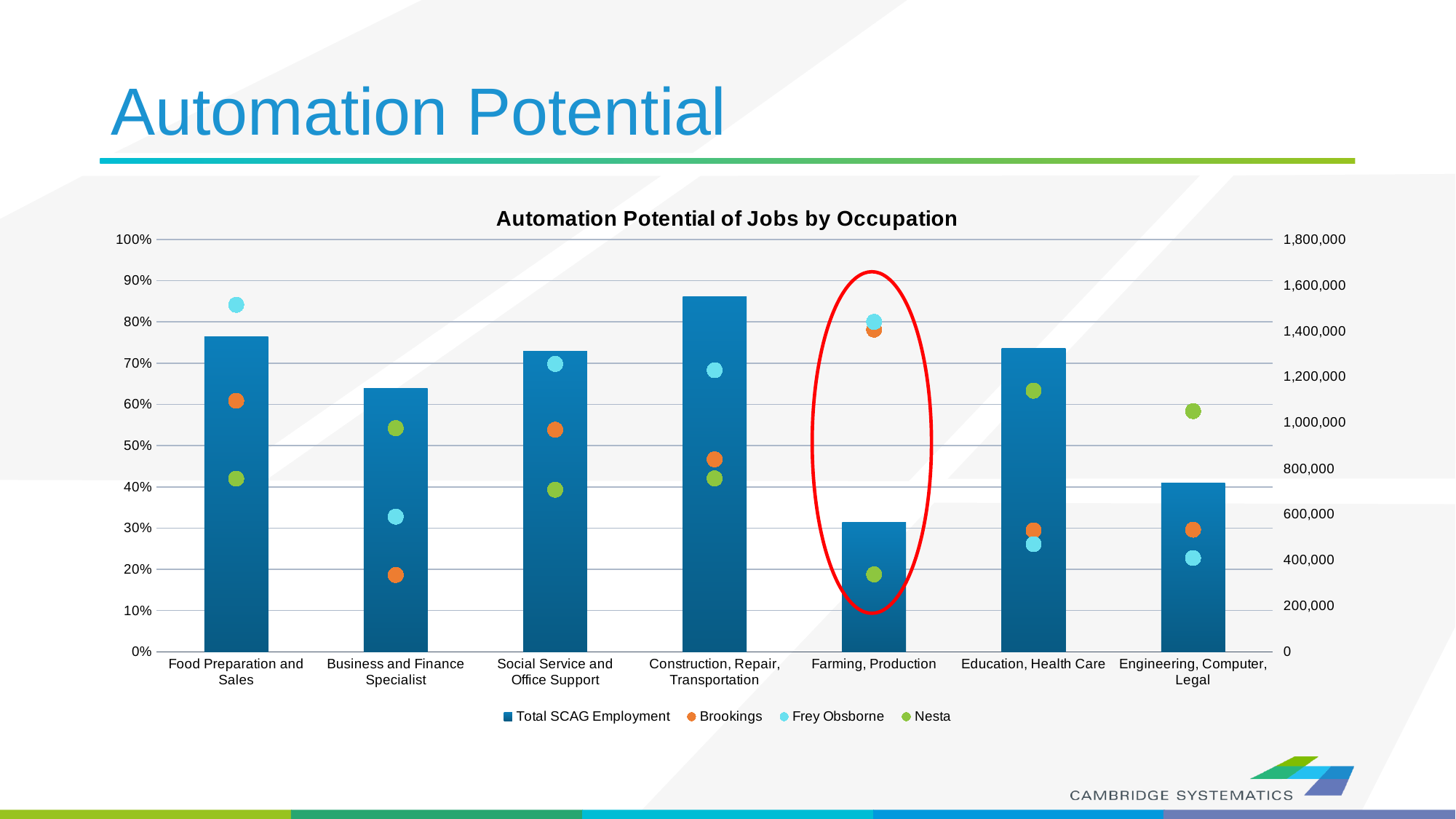
Is the Nesta value for Engineering, Computer, Legal greater or less than 50%? greater Which occupation category has the lowest Total SCAG Employment bar? Farming, Production Which occupation category is circled in red on the chart? Farming, Production How many occupation categories are shown on the x axis? 7 Is the Total SCAG Employment value for Farming, Production greater or less than 800,000? less Which is larger: the Frey Obsborne value for Food Preparation and Sales or the Frey Obsborne value for Business and Finance Specialist? Food Preparation and Sales Is the Brookings value for Business and Finance Specialist greater or less than 30%? less What is the title of the chart? Automation Potential of Jobs by Occupation How many series does the chart legend list? 4 Which occupation category has the highest Total SCAG Employment bar? Construction, Repair, Transportation